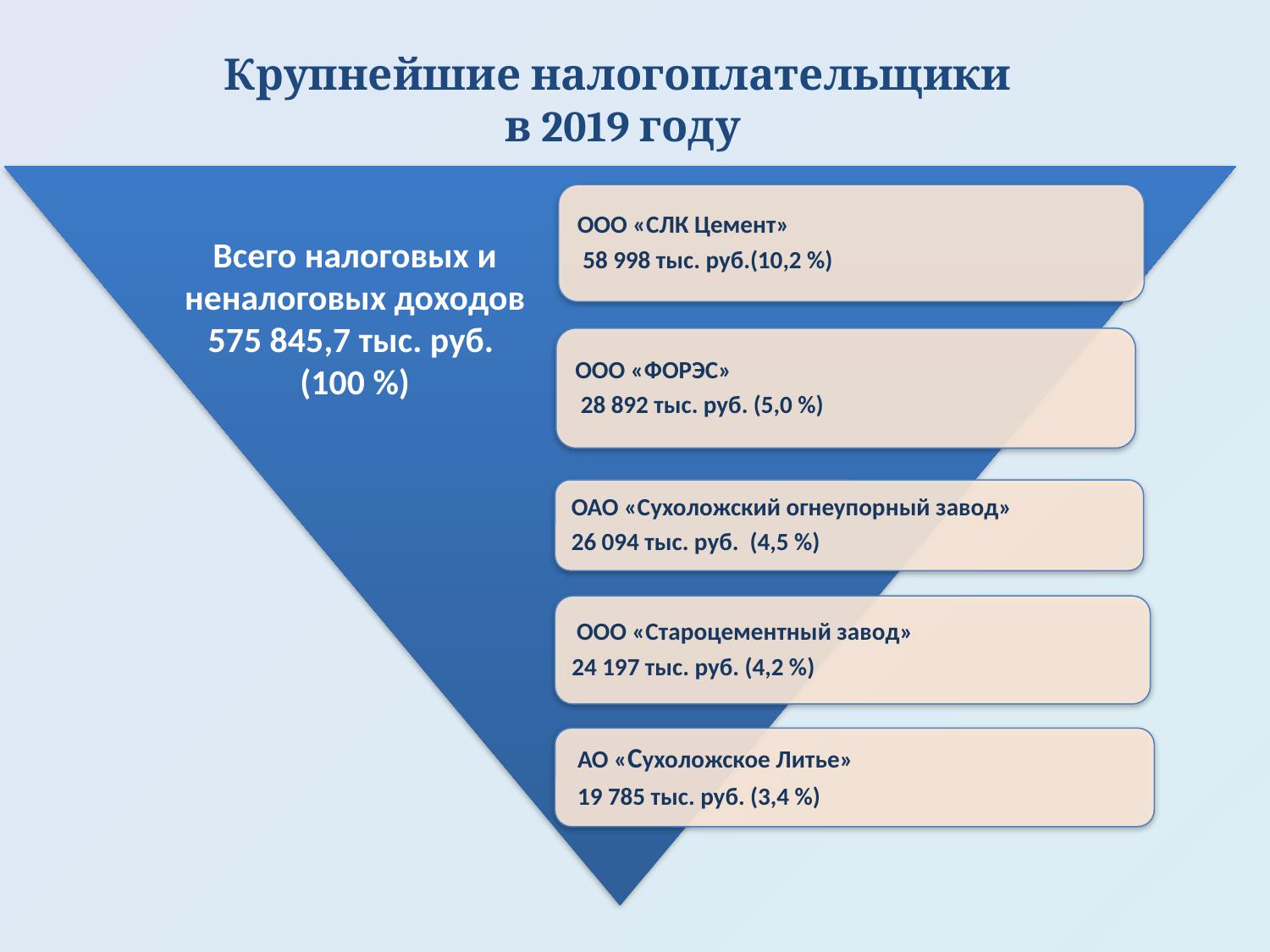
Which taxpayer has the smallest amount? АО «Сухоложское Литье» What is the title of the slide? Крупнейшие налогоплательщики в 2019 году What amount is shown for ОАО «Сухоложский огнеупорный завод»? 26 094 тыс. руб. What amount is shown for АО «Сухоложское Литье»? 19 785 тыс. руб. What share is shown for ООО «Староцементный завод»? 4,2 % Which is larger, the amount for ОАО «Сухоложский огнеупорный завод» or for ООО «Староцементный завод»? ОАО «Сухоложский огнеупорный завод» What is the total of tax and non-tax revenues shown on the slide? 575 845,7 тыс. руб. What amount is shown for ООО «СЛК Цемент»? 58 998 тыс. руб. How many taxpayers are listed in the diagram? 5 Which taxpayer has the largest amount? ООО «СЛК Цемент» What share of total revenue is shown for ООО «ФОРЭС»? 5,0 % What is the difference in amount between ООО «СЛК Цемент» and ООО «ФОРЭС»? 30 106 тыс. руб.